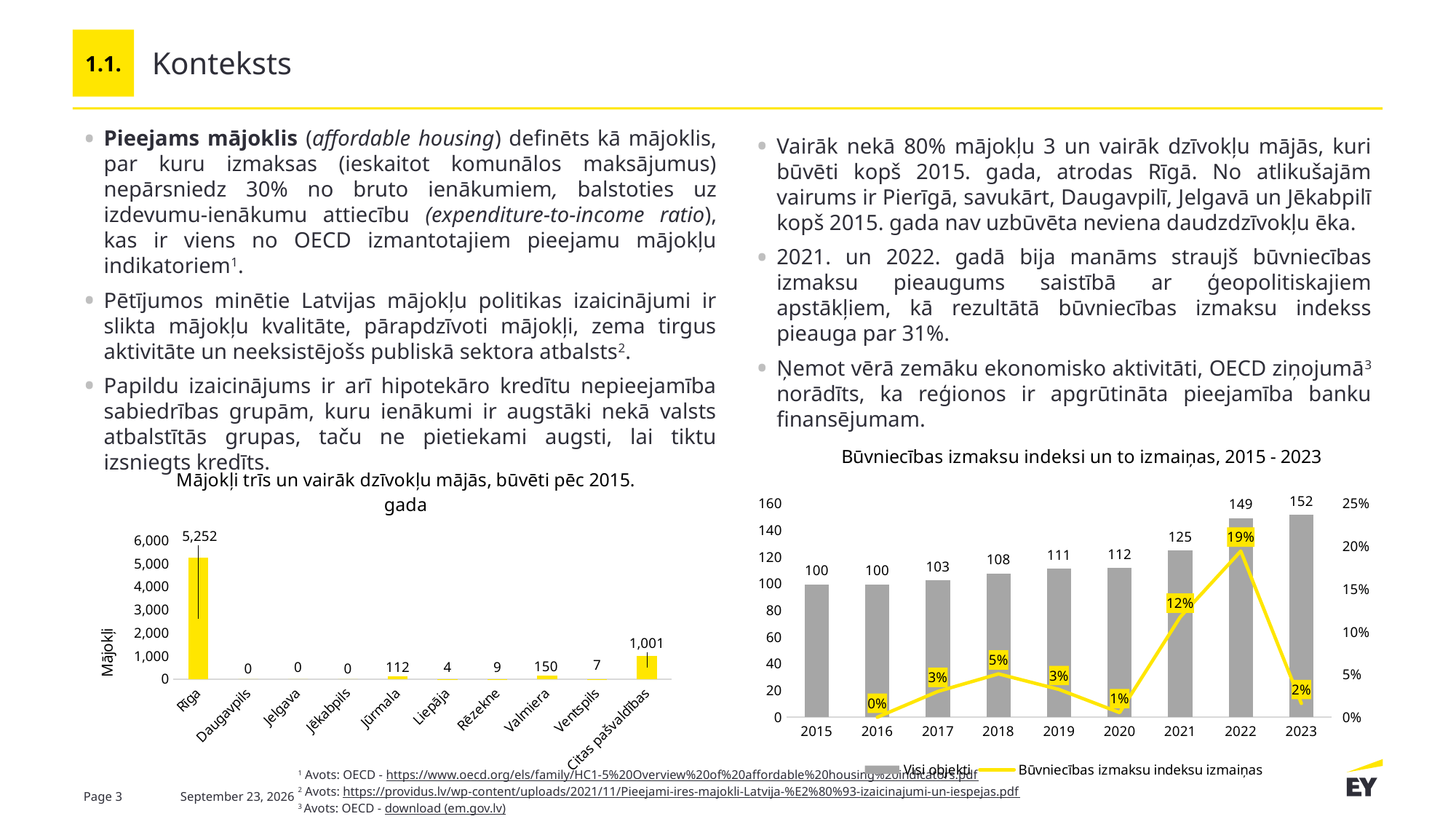
In the chart 'Mājokļi trīs un vairāk dzīvokļu mājās, būvēti pēc 2015. gada', which category has the highest value? Rīga In the chart 'Būvniecības izmaksu indeksi un to izmaiņas, 2015 - 2023', what is the index value (bar) for 2021? 125 In the chart 'Būvniecības izmaksu indeksi un to izmaiņas, 2015 - 2023', how many series does the legend list? 2 In the chart 'Būvniecības izmaksu indeksi un to izmaiņas, 2015 - 2023', what is the percentage change shown for 2022? 19% In the chart 'Mājokļi trīs un vairāk dzīvokļu mājās, būvēti pēc 2015. gada', what is the difference between Valmiera and Jūrmala? 38 In the chart 'Būvniecības izmaksu indeksi un to izmaiņas, 2015 - 2023', what is the difference between the index values for 2023 and 2015? 52 In the chart 'Būvniecības izmaksu indeksi un to izmaiņas, 2015 - 2023', do the index bar values rise or fall from 2015 to 2023? rise In the chart 'Mājokļi trīs un vairāk dzīvokļu mājās, būvēti pēc 2015. gada', what is the value for Citas pašvaldības? 1,001 In the chart 'Mājokļi trīs un vairāk dzīvokļu mājās, būvēti pēc 2015. gada', what is the value for Rīga? 5,252 In the chart 'Mājokļi trīs un vairāk dzīvokļu mājās, būvēti pēc 2015. gada', which is larger, Rēzekne or Ventspils? Rēzekne In the chart 'Mājokļi trīs un vairāk dzīvokļu mājās, būvēti pēc 2015. gada', how many categories are shown on the x axis? 10 In the chart 'Būvniecības izmaksu indeksi un to izmaiņas, 2015 - 2023', which year has the highest index value? 2023